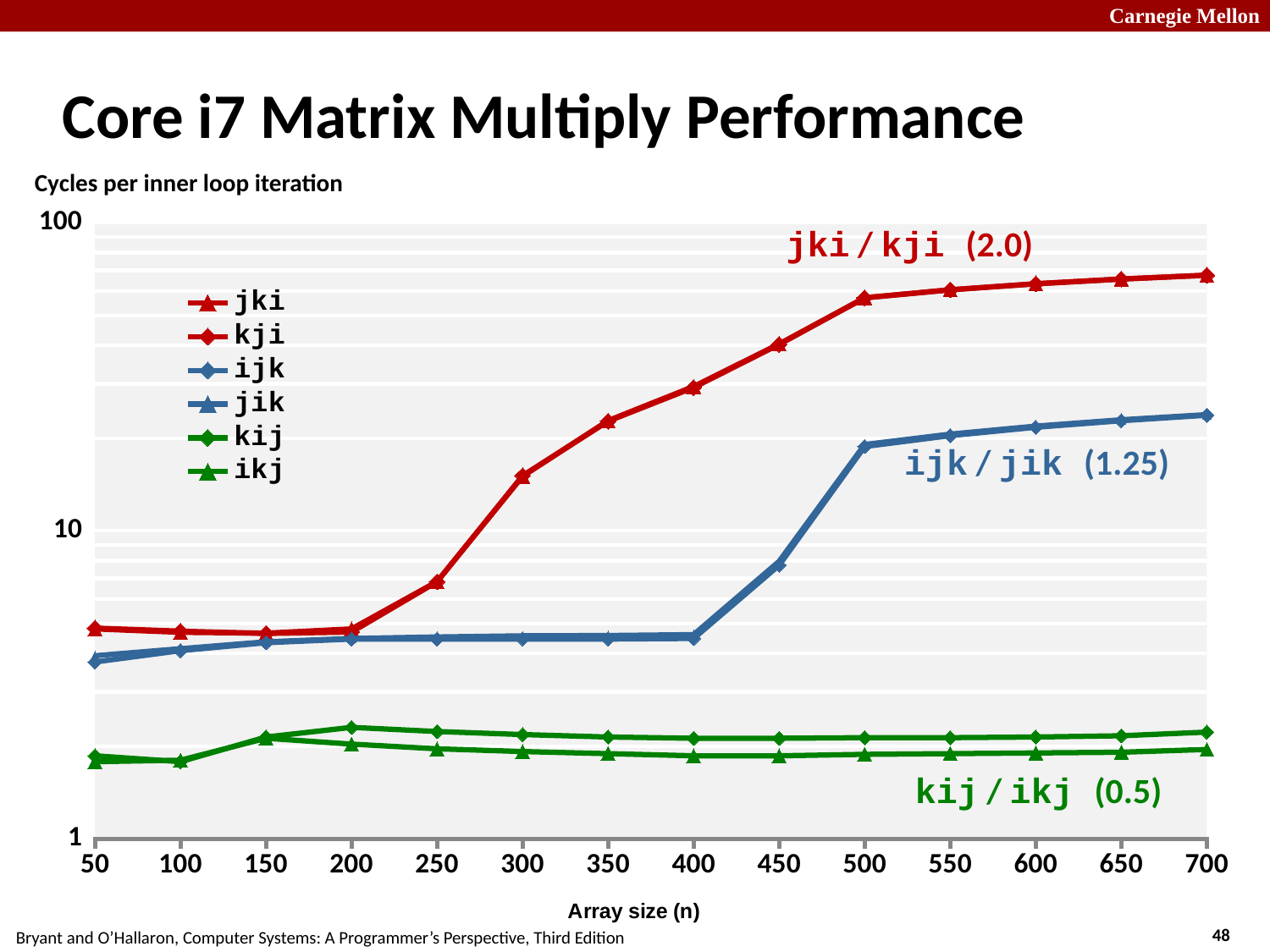
Is the value for jki at array size 200 greater or less than 10? less Is the value for ijk at array size 300 greater or less than 10? less At array size 700, which has the larger value: jki or kij? jki What is the label on the x axis of the chart? Array size (n) At array size 400, which has the larger value: ijk or jki? jki Does the jki series rise or fall as array size increases from 50 to 700? rise How many series does the legend list? 6 Is the value for ikj at array size 700 greater or less than 10? less What kind of chart is shown on the slide? line chart How many array size values are marked along the x axis? 14